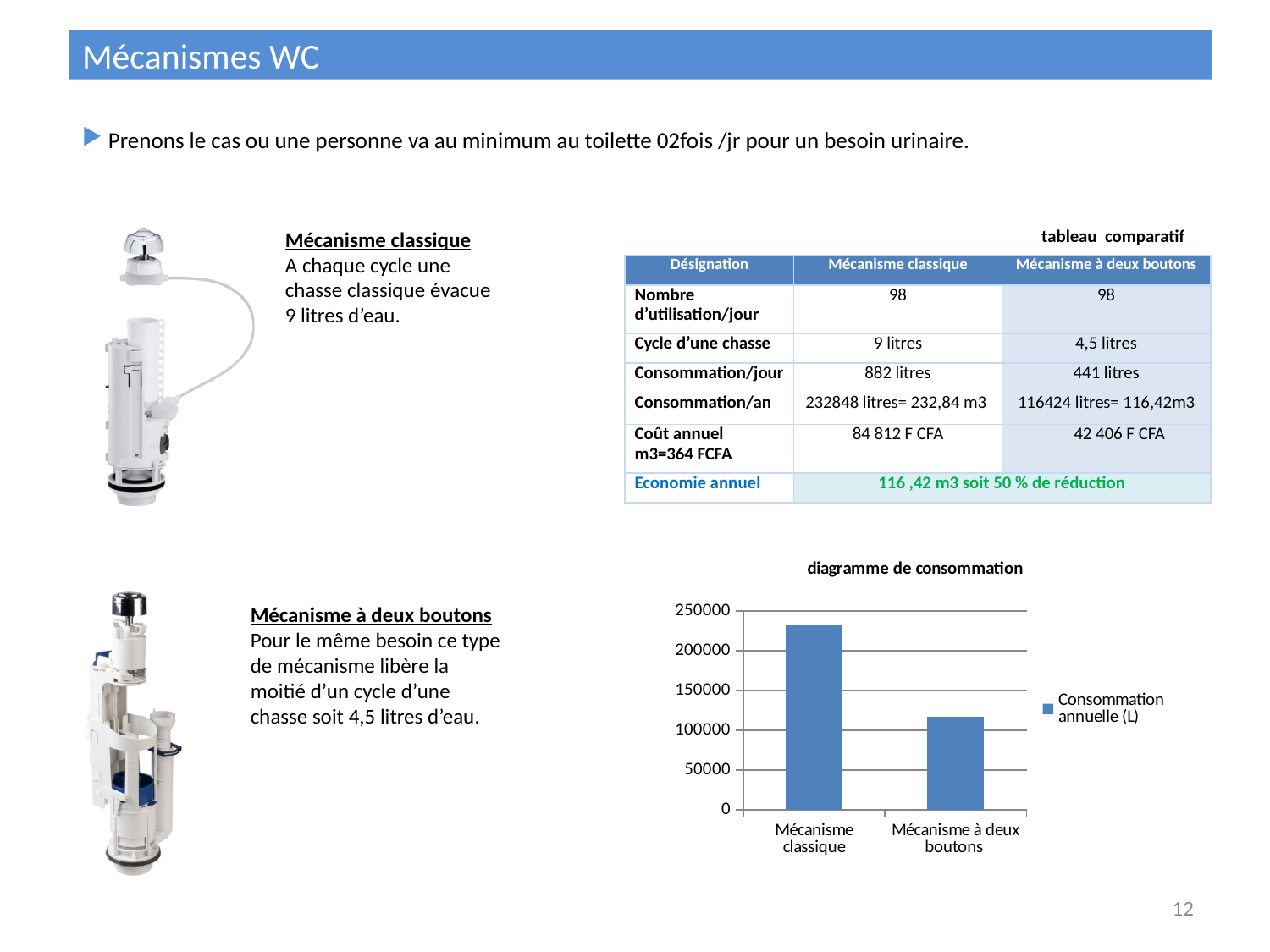
In the 'diagramme de consommation' chart, is the value for Mécanisme à deux boutons greater or less than 150000? less In the 'diagramme de consommation' chart, do the bars rise or fall from left to right along the x axis? fall In the 'diagramme de consommation' chart, which is larger: the bar for Mécanisme classique or the bar for Mécanisme à deux boutons? Mécanisme classique What kind of chart is the 'diagramme de consommation'? bar chart In the 'diagramme de consommation' chart, which category has the highest annual consumption? Mécanisme classique In the 'diagramme de consommation' chart, which category has the lowest annual consumption? Mécanisme à deux boutons In the 'diagramme de consommation' chart, is the value for Mécanisme classique greater or less than 200000? greater In the 'diagramme de consommation' chart, is the value for Mécanisme à deux boutons greater or less than 100000? greater How many categories are shown on the x axis of the 'diagramme de consommation' chart? 2 What series name does the legend of the 'diagramme de consommation' chart show? Consommation annuelle (L) How many series does the legend of the 'diagramme de consommation' chart list? 1 What is the title of the bar chart on the slide? diagramme de consommation